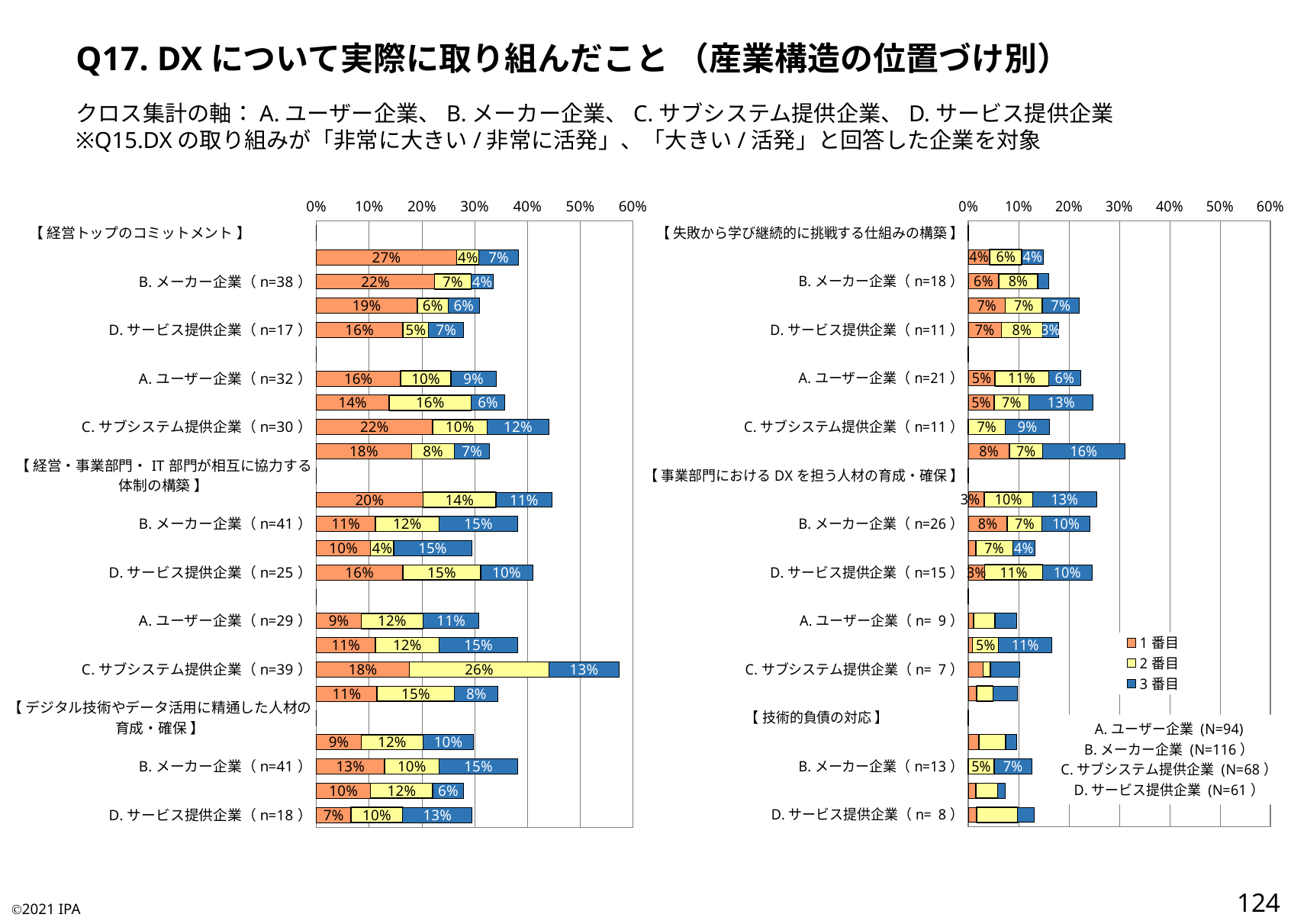
In the right chart, what is the 2番目 value for A. ユーザー企業 (n=21)? 11% In the left chart, what is the 3番目 value for D. サービス提供企業 (n=18)? 13% In the right chart, which is larger for D. サービス提供企業 (n=15): the 2番目 value or the 3番目 value? 2番目 In the left chart, what is the total of the stacked bar for C. サブシステム提供企業 (n=39)? 57% In the right chart, what is the total of the stacked bar for B. メーカー企業 (n=26)? 25% In the left chart, is the total bar for C. サブシステム提供企業 (n=39) greater or less than 50%? greater In the left chart, what is the 1番目 value for B. メーカー企業 (n=38)? 22% What kind of chart is shown on the left side of the slide? Stacked bar chart How many series does the legend on the right chart list? 3 In the left chart, what is the difference between the 1番目 value and the 3番目 value for D. サービス提供企業 (n=25)? 6% In the left chart, what is the 2番目 value for C. サブシステム提供企業 (n=39)? 26% In the left chart, what is the total of the stacked bar for A. ユーザー企業 (n=32)? 35%